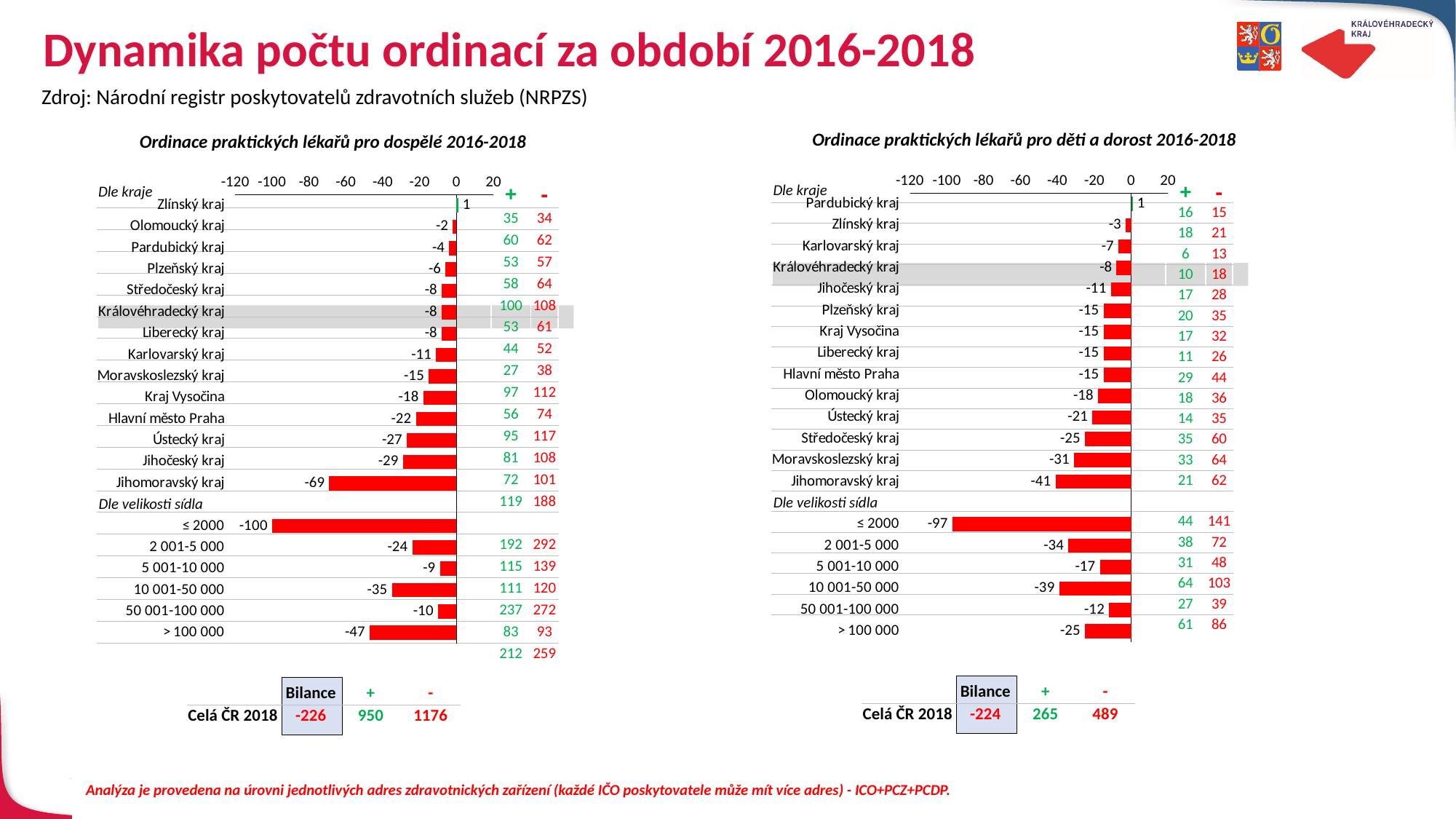
In the chart 'Ordinace praktických lékařů pro děti a dorost 2016-2018', what is the value for Královéhradecký kraj? -8 What type of chart is 'Ordinace praktických lékařů pro dospělé 2016-2018'? Bar chart In the chart 'Ordinace praktických lékařů pro děti a dorost 2016-2018', which is larger, the value for Moravskoslezský kraj or the value for Ústecký kraj? Ústecký kraj In the chart 'Ordinace praktických lékařů pro děti a dorost 2016-2018', which category has the lowest value? ≤ 2000 In the chart 'Ordinace praktických lékařů pro dospělé 2016-2018', which category has the lowest value? ≤ 2000 How many regions (kraje) are listed in the chart 'Ordinace praktických lékařů pro děti a dorost 2016-2018'? 14 In the chart 'Ordinace praktických lékařů pro dospělé 2016-2018', which region (kraj) has the highest value? Zlínský kraj In the chart 'Ordinace praktických lékařů pro dospělé 2016-2018', what is the value for Hlavní město Praha? -22 In the chart 'Ordinace praktických lékařů pro dospělé 2016-2018', what is the difference between the values for Jihomoravský kraj and Jihočeský kraj? 40 In the chart 'Ordinace praktických lékařů pro dospělé 2016-2018', what is the value for Jihomoravský kraj? -69 In the chart 'Ordinace praktických lékařů pro děti a dorost 2016-2018', what is the difference between the values for 10 001-50 000 and 2 001-5 000? 5 In the chart 'Ordinace praktických lékařů pro děti a dorost 2016-2018', what is the value for the category > 100 000? -25